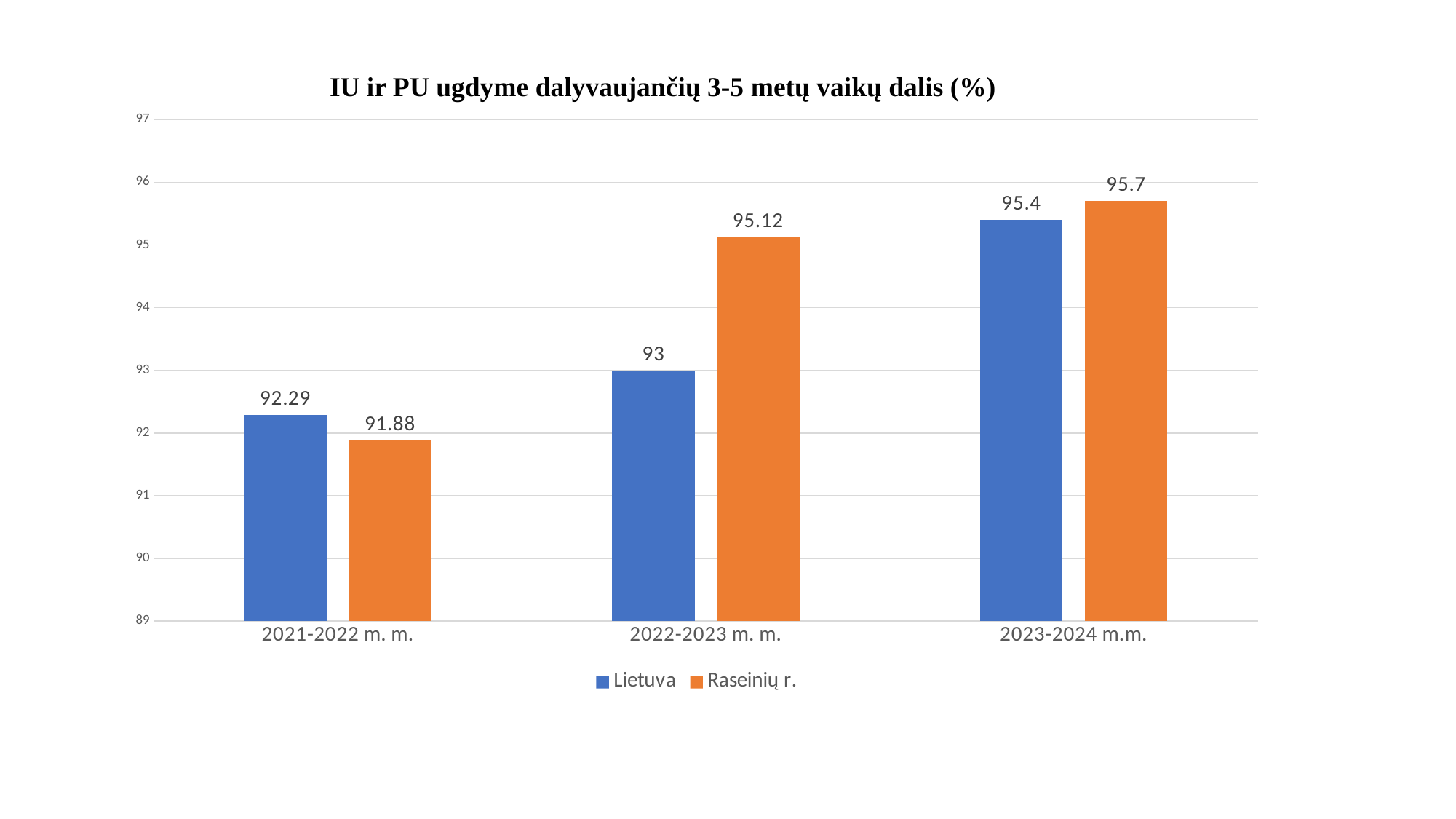
How many school years are shown on the x axis? 3 What is the difference between Raseinių r. and Lietuva in 2022-2023 m. m.? 2.12 Do the Raseinių r. values rise or fall from 2021-2022 m. m. to 2023-2024 m.m.? Rise In which school year is the Raseinių r. value highest? 2023-2024 m.m. How many series does the legend list? 2 What kind of chart is shown on the slide? Bar chart What is the value for Lietuva in 2022-2023 m. m.? 93 Which is larger in 2021-2022 m. m., Lietuva or Raseinių r.? Lietuva What is the value for Raseinių r. in 2023-2024 m.m.? 95.7 What is the value for Raseinių r. in 2022-2023 m. m.? 95.12 What is the value for Lietuva in 2021-2022 m. m.? 92.29 In which school year is the Lietuva value lowest? 2021-2022 m. m.